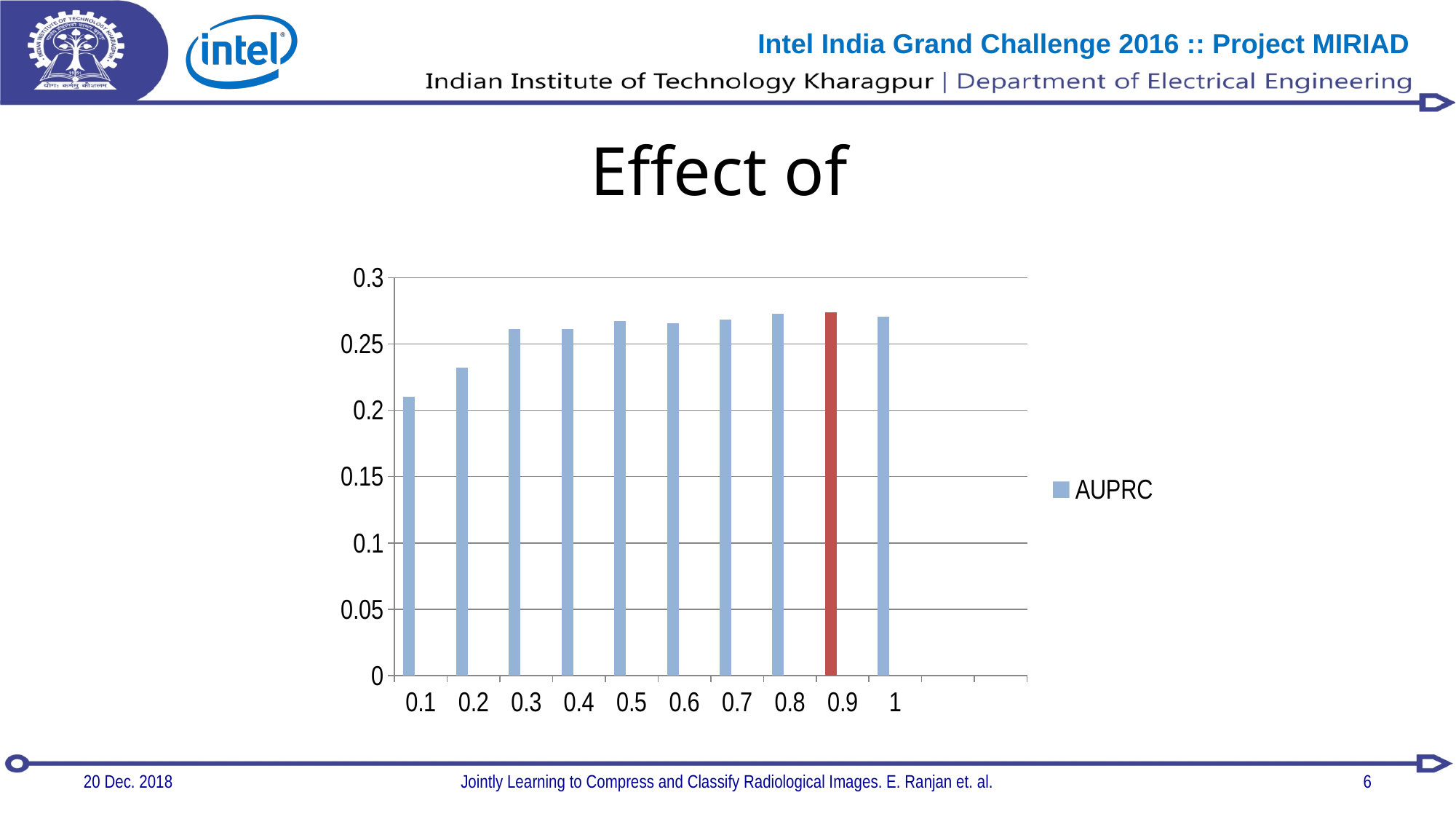
Which has a larger AUPRC value, 0.2 or 0.3? 0.3 Which x-axis category has the lowest AUPRC value? 0.1 How many series does the legend list? 1 Which has a larger AUPRC value, 0.1 or 0.2? 0.2 How many bars are plotted in the chart? 10 What is the name of the series shown in the legend? AUPRC Which bar is drawn in a different colour (red) from the others? 0.9 What kind of chart is shown on the slide? bar chart Is the AUPRC value for 0.3 greater or less than 0.25? greater Is the AUPRC value for 0.1 greater or less than 0.25? less Is the AUPRC value for 0.9 greater or less than 0.3? less